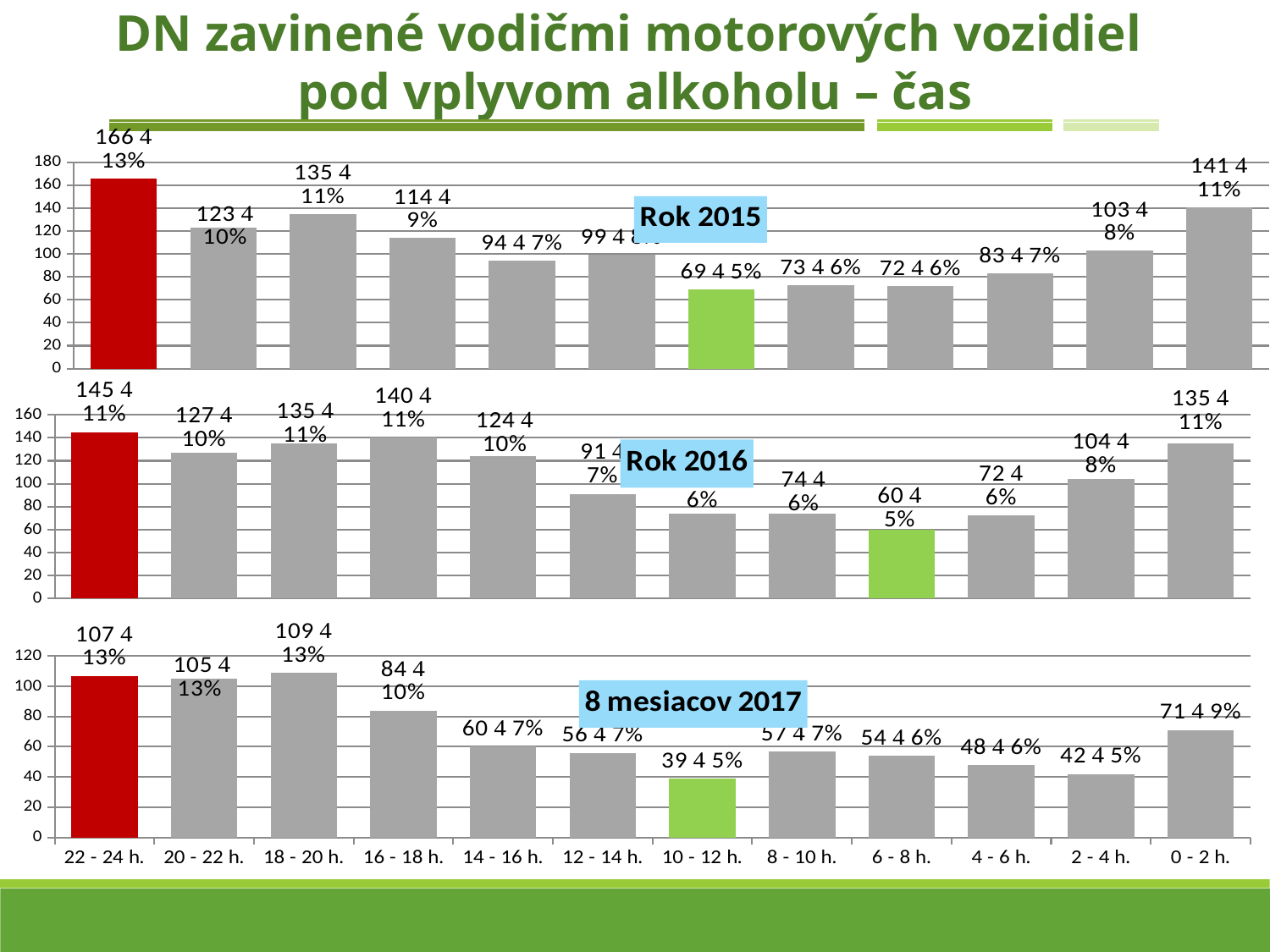
In the 8 mesiacov 2017 chart, what percentage is shown for 22 - 24 h.? 13% In the Rok 2015 chart, what is the difference between the values for 22 - 24 h. and 0 - 2 h.? 25 How many charts are shown on the slide? 3 In the Rok 2016 chart, what is the value for 16 - 18 h.? 140 In the Rok 2016 chart, which is larger, the value for 20 - 22 h. or for 18 - 20 h.? 18 - 20 h. What kind of chart is used for the Rok 2015 data? bar chart In the 8 mesiacov 2017 chart, what is the value for 0 - 2 h.? 71 In the Rok 2016 chart, which time interval has the lowest value? 6 - 8 h. In the Rok 2015 chart, which time interval has the highest value? 22 - 24 h. In the 8 mesiacov 2017 chart, which time interval has the lowest value? 10 - 12 h. In the Rok 2015 chart, which time interval has the lowest value? 10 - 12 h. In the 8 mesiacov 2017 chart, how many time-interval categories are plotted? 12